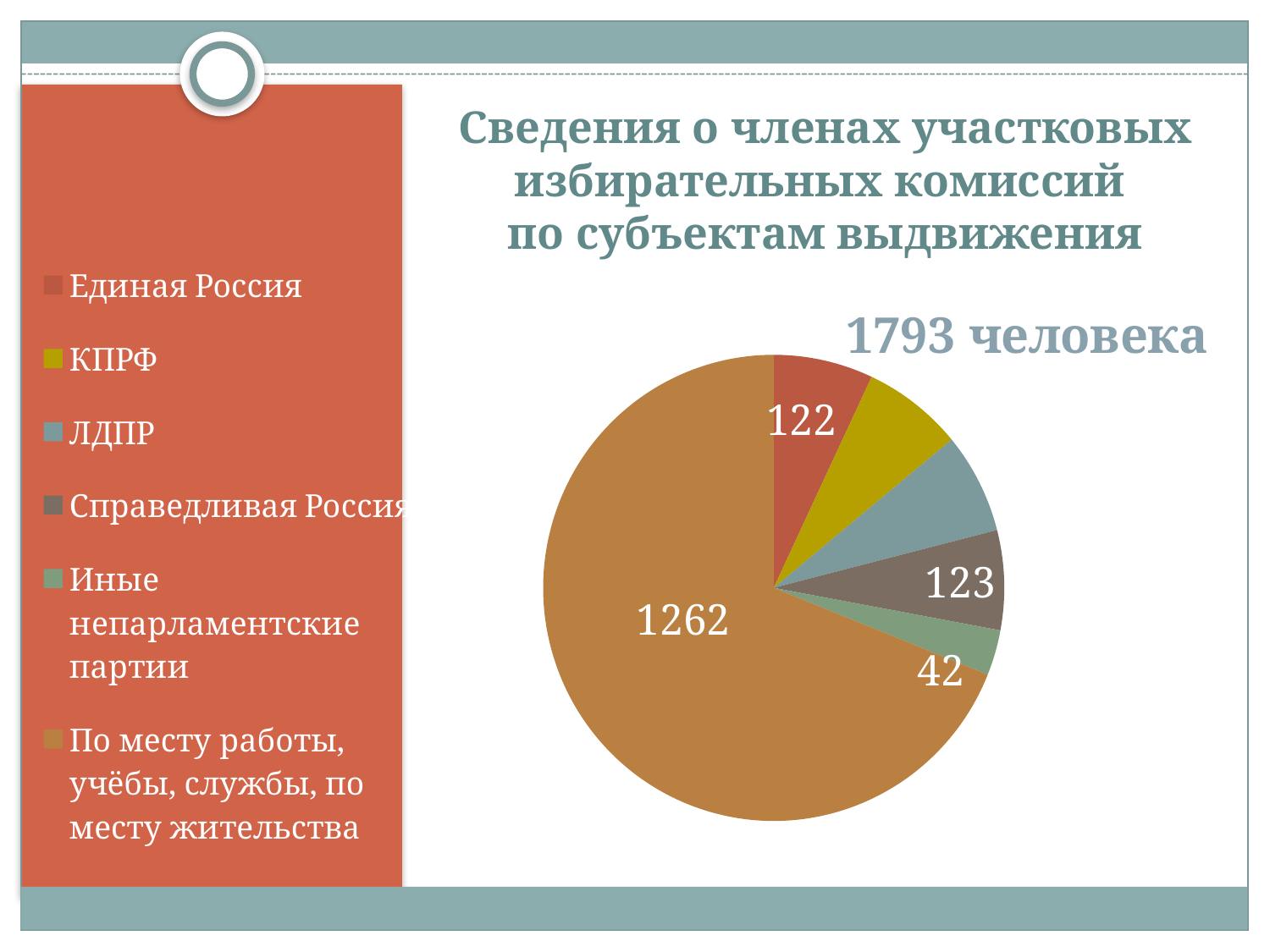
Which category has the smallest slice of the pie chart? Иные непарламентские партии Which category has the largest slice of the pie chart? По месту работы, учёбы, службы, по месту жительства Which is larger: the value for По месту работы, учёбы, службы, по месту жительства or the value for Единая Россия? По месту работы, учёбы, службы, по месту жительства What value is shown for Справедливая Россия on the pie chart? 123 What is the difference between the values for Справедливая Россия and Единая Россия? 1 What is the difference between the values for По месту работы, учёбы, службы, по месту жительства and Единая Россия? 1140 What kind of chart is shown on the slide? Pie chart What value is shown for По месту работы, учёбы, службы, по месту жительства on the pie chart? 1262 What value is shown for Иные непарламентские партии on the pie chart? 42 How many categories does the pie chart have? 6 What total number of people is stated next to the pie chart? 1793 человека What value is shown for Единая Россия on the pie chart? 122